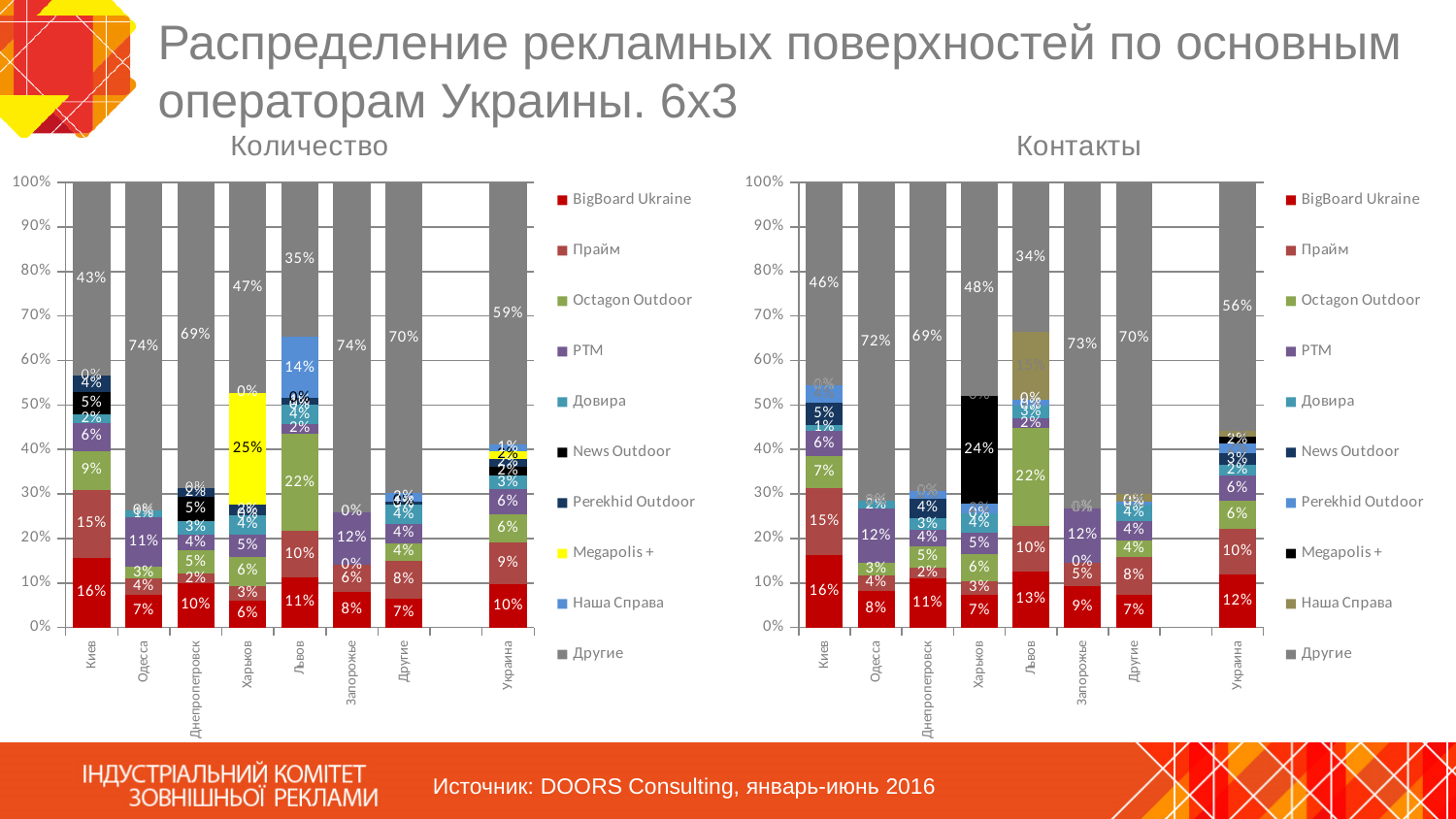
How many series does the legend of the "Контакты" chart list? 10 In the "Контакты" chart, which is larger: the "BigBoard Ukraine" segment for Киев or for Одесса? Киев In the "Количество" chart, which category has the lowest "Другие" segment value? Львов How many categories are shown on the x axis of the "Количество" chart? 8 What type of chart is the "Количество" chart on the left? stacked bar chart In the "Количество" chart, what is the value of the "Другие" segment for Киев? 43% In the "Количество" chart, what is the value of the "Megapolis +" segment for Харьков? 25% In the "Контакты" chart, what is the value of the "Другие" segment for Украина? 56% In the "Количество" chart, what is the value of the "Octagon Outdoor" segment for Львов? 22% In the "Контакты" chart, what is the value of the "BigBoard Ukraine" segment for Львов? 13% In the "Количество" chart, what is the difference between the "Другие" segment values for Одесса and Киев? 31% In the "Контакты" chart, which category has the highest "Другие" segment value? Запорожье